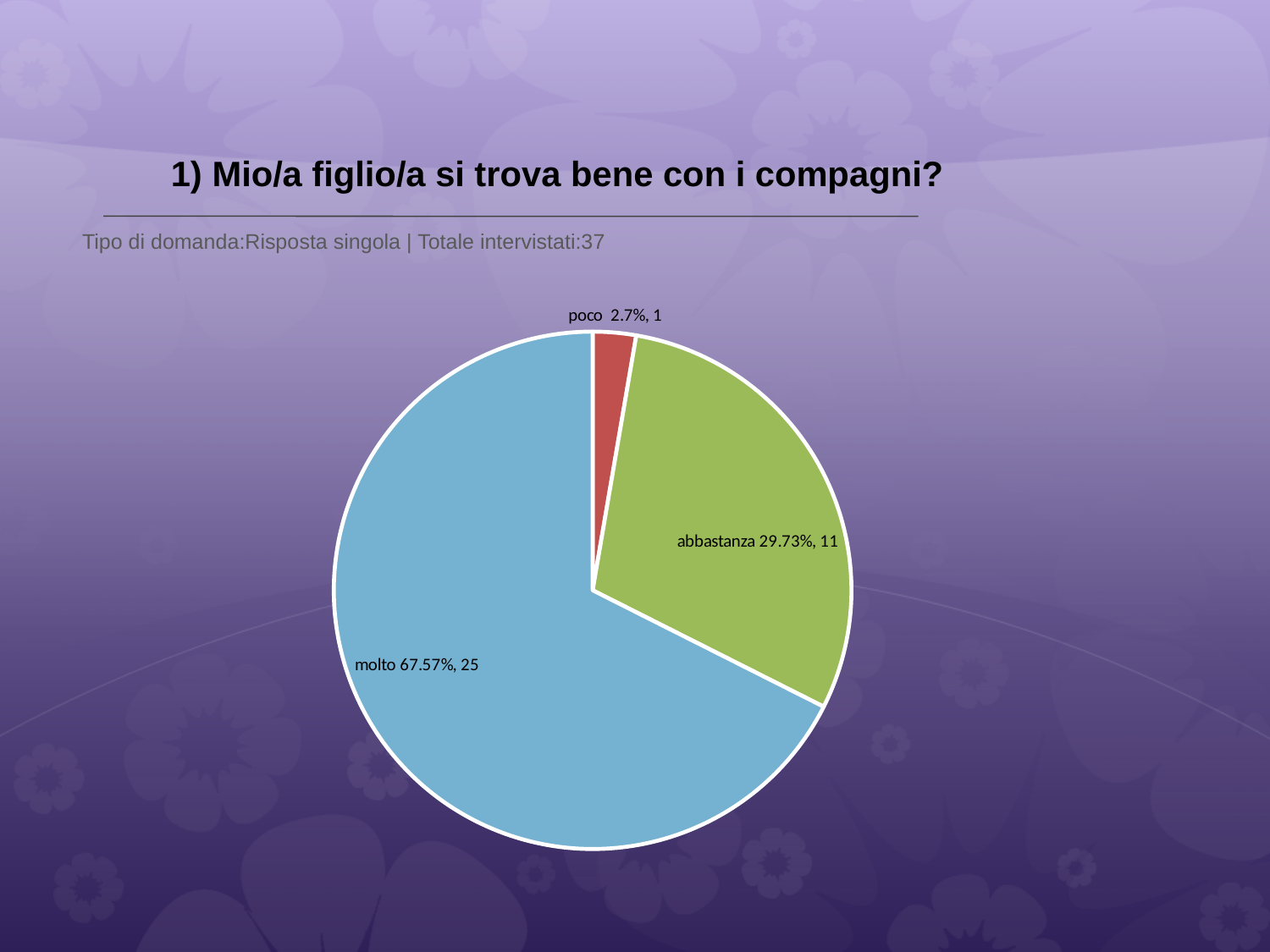
Which category has the smallest slice? poco Which category has the largest slice? molto What is the difference in respondent count between 'molto' and 'abbastanza'? 14 What kind of chart is shown on the slide? pie chart What percentage share does the 'abbastanza' slice have? 29.73% What percentage share does the 'molto' slice have? 67.57% How many respondents answered 'abbastanza'? 11 What percentage share does the 'poco' slice have? 2.7% Which slice is larger, 'abbastanza' or 'poco'? abbastanza How many respondents answered 'poco'? 1 How many respondents answered 'molto'? 25 How many slices does the pie chart have? 3